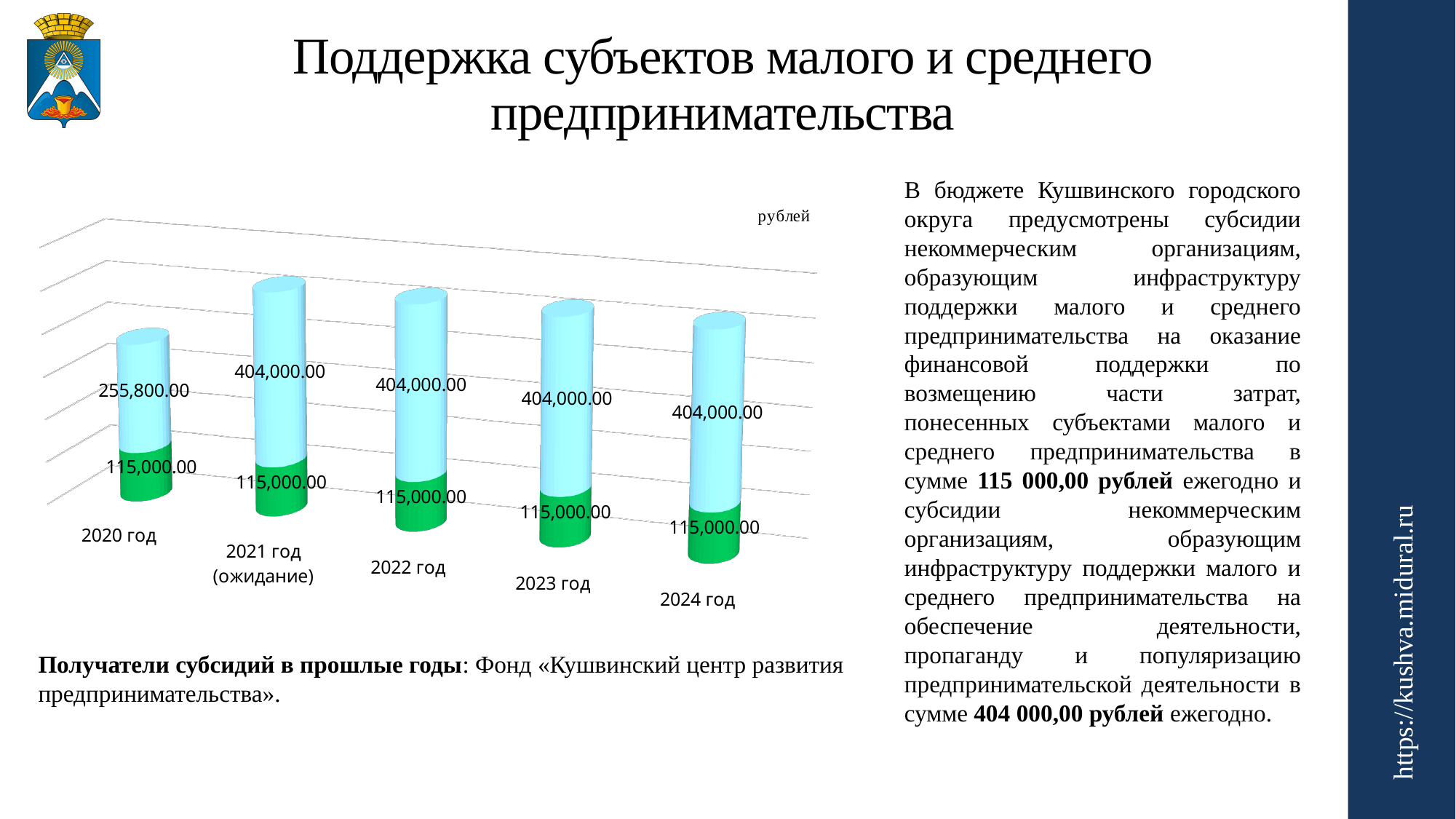
What kind of chart is shown on the slide? Stacked bar chart What is the total of the stacked bar for 2020 год? 370,800.00 What is the difference between the light blue segment for 2022 год and the light blue segment for 2020 год? 148,200.00 What is the value of the light blue segment for 2024 год? 404,000.00 What unit is indicated in the top right corner of the chart? рублей What is the total of the stacked bar for 2023 год? 519,000.00 What is the value of the light blue segment for 2020 год? 255,800.00 Does the green segment value change across the years shown? No, it stays at 115,000.00 Which year has the lowest value for the light blue segment? 2020 год How many years are shown on the x axis of the chart? 5 Which is larger: the light blue segment for 2021 год (ожидание) or the light blue segment for 2020 год? 2021 год (ожидание) What is the value of the green segment for 2023 год? 115,000.00